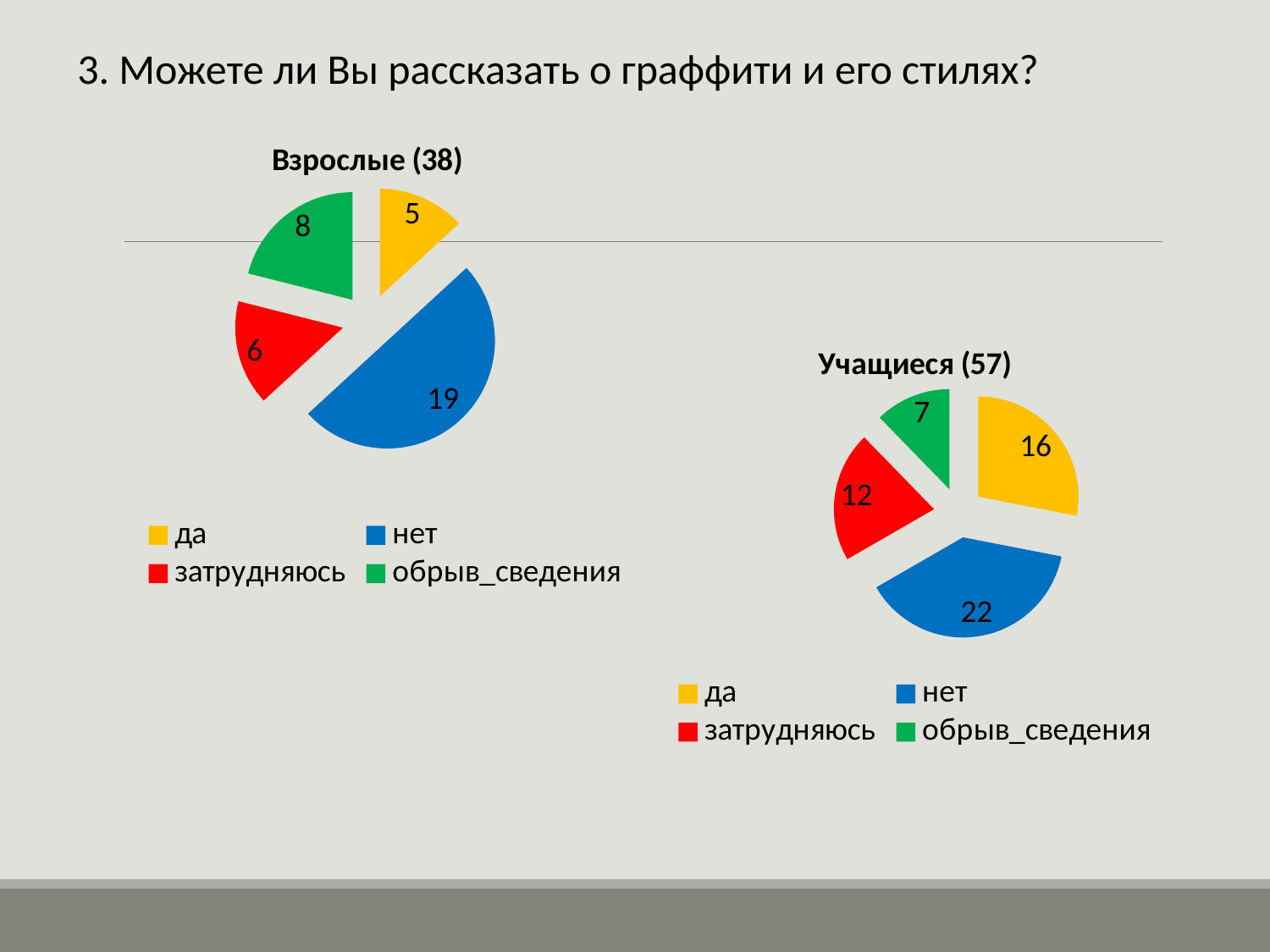
In the 'Взрослые (38)' chart, what is the value for 'нет'? 19 What type of chart is used for 'Взрослые (38)'? pie chart In the 'Учащиеся (57)' chart, what is the value for 'да'? 16 In the 'Учащиеся (57)' chart, which category has the largest value? нет In the 'Взрослые (38)' chart, what share of the pie does 'нет' represent? 50% In the 'Учащиеся (57)' chart, what is the value for 'затрудняюсь'? 12 How many slices does the 'Учащиеся (57)' chart have? 4 In the 'Взрослые (38)' chart, which is larger: 'затрудняюсь' or 'обрыв_сведения'? обрыв_сведения In the 'Учащиеся (57)' chart, what is the difference between 'нет' and 'да'? 6 In the 'Учащиеся (57)' chart, which category has the smallest value? обрыв_сведения In the 'Взрослые (38)' chart, which category has the smallest value? да In the 'Взрослые (38)' chart, what is the difference between 'нет' and 'обрыв_сведения'? 11